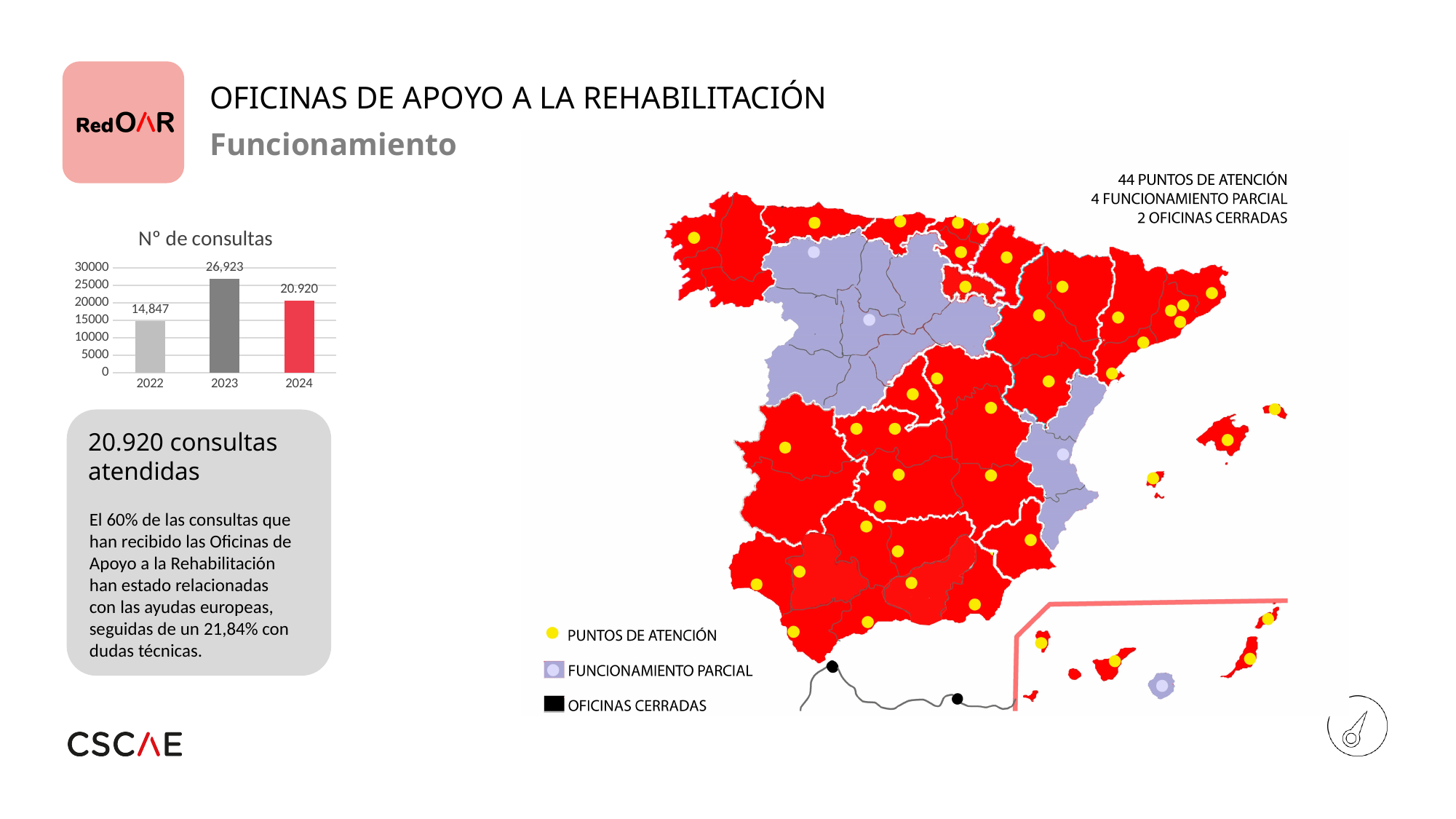
In the 'Nº de consultas' chart, do the values rise or fall from 2023 to 2024? fall In the 'Nº de consultas' chart, what is the value for 2024? 20.920 In the 'Nº de consultas' chart, which is larger, the value for 2023 or the value for 2024? 2023 In the 'Nº de consultas' chart, which year has the highest value? 2023 How many years are shown on the x axis of the 'Nº de consultas' chart? 3 In the 'Nº de consultas' chart, what is the difference between the 2023 and 2022 values? 12,076 In the 'Nº de consultas' chart, what is the difference between the 2023 and 2024 values? 6,003 In the 'Nº de consultas' chart, is the value for 2022 greater or less than 20000? less In the 'Nº de consultas' chart, what is the value for 2023? 26,923 In the 'Nº de consultas' chart, what is the value for 2022? 14,847 What type of chart is the 'Nº de consultas' chart? bar chart In the 'Nº de consultas' chart, which year has the lowest value? 2022